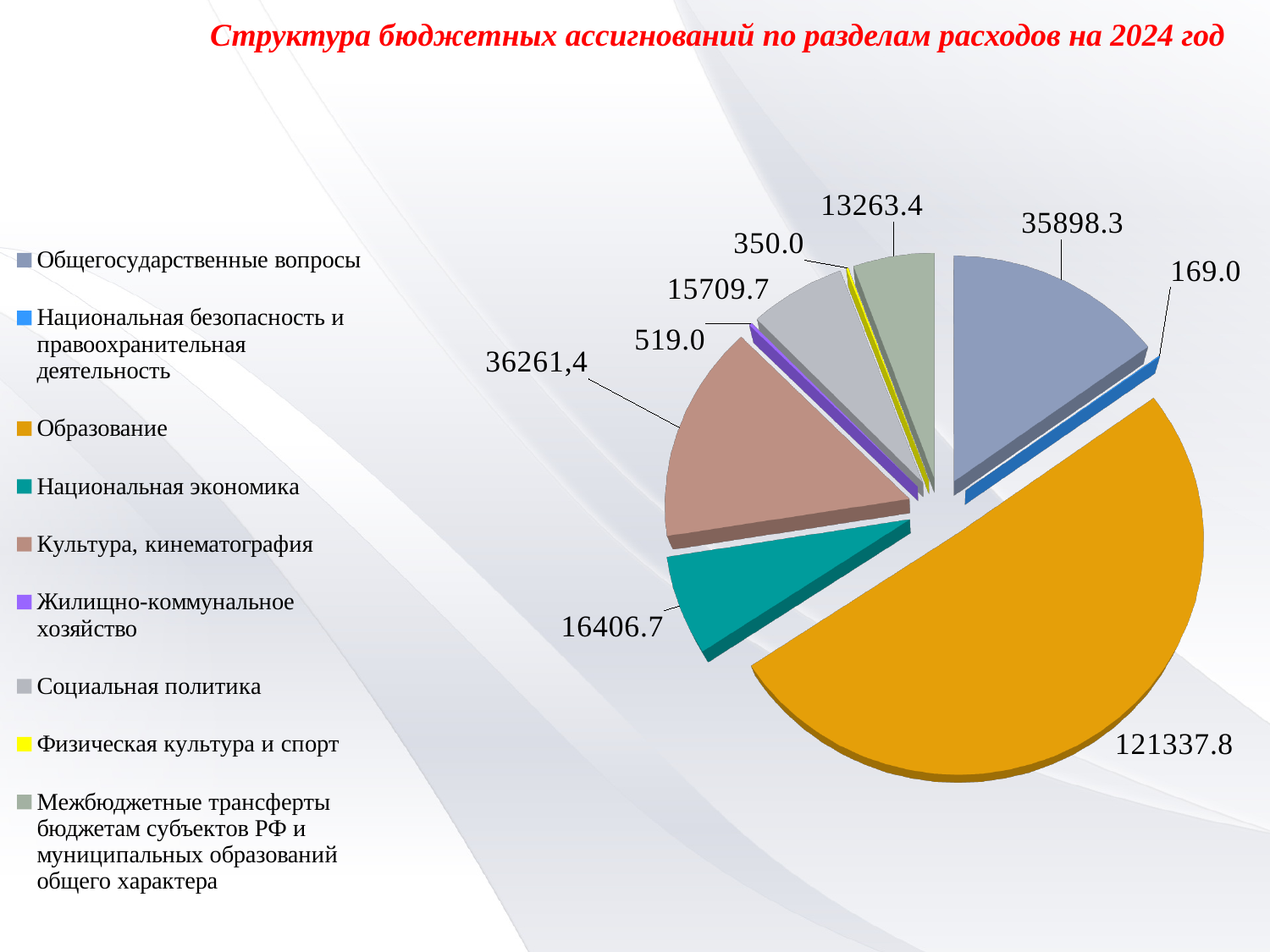
What is the difference between the values for Национальная экономика and Социальная политика? 697.0 Which is larger, the value for Жилищно-коммунальное хозяйство or the value for Физическая культура и спорт? Жилищно-коммунальное хозяйство How many categories does the legend list? 9 What is the value for Национальная экономика? 16406.7 What is the value for Общегосударственные вопросы? 35898.3 What is the value for Образование? 121337.8 Which category has the smallest value? Национальная безопасность и правоохранительная деятельность What is the title of the chart? Структура бюджетных ассигнований по разделам расходов на 2024 год Which category has the largest slice of the pie? Образование What is the value for Социальная политика? 15709.7 What kind of chart is shown on the slide? pie chart What is the value for Межбюджетные трансферты бюджетам субъектов РФ и муниципальных образований общего характера? 13263.4